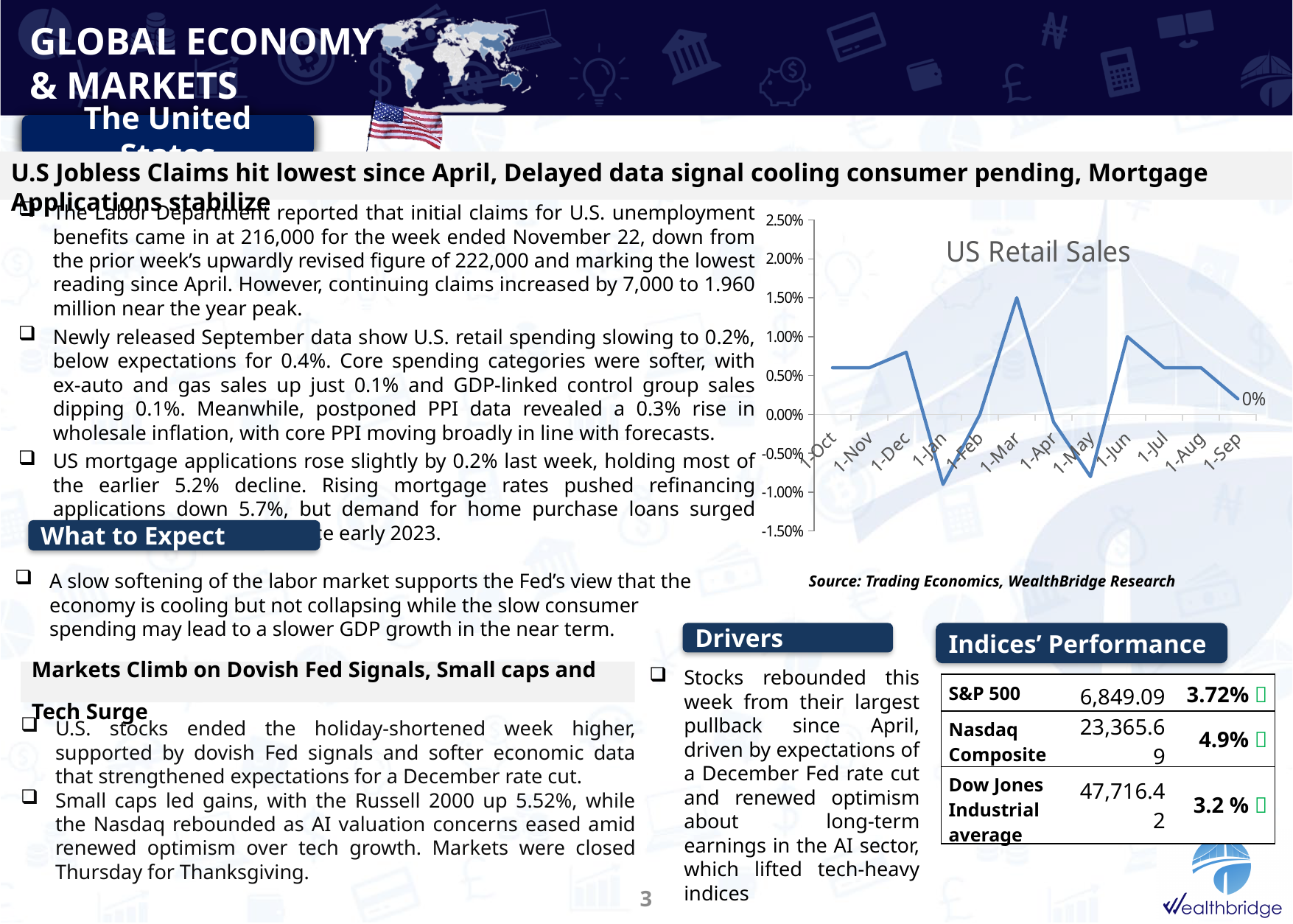
What kind of chart is the US Retail Sales chart? line chart Is the value for 1-Oct on the US Retail Sales chart greater or less than 1.00%? less Is the value for 1-Dec on the US Retail Sales chart greater or less than 0.50%? greater Which month has the highest value on the US Retail Sales chart? 1-Mar What source is cited below the US Retail Sales chart? Trading Economics, WealthBridge Research On the US Retail Sales chart, do the values rise or fall from 1-Jun to 1-Sep? fall On the US Retail Sales chart, which is larger, the value for 1-Mar or the value for 1-Jun? 1-Mar Is the value for 1-Mar on the US Retail Sales chart greater or less than 1.00%? greater How many data points are plotted on the US Retail Sales chart? 12 What is the title of the chart on the slide? US Retail Sales What value is labelled for 1-Sep on the US Retail Sales chart? 0%